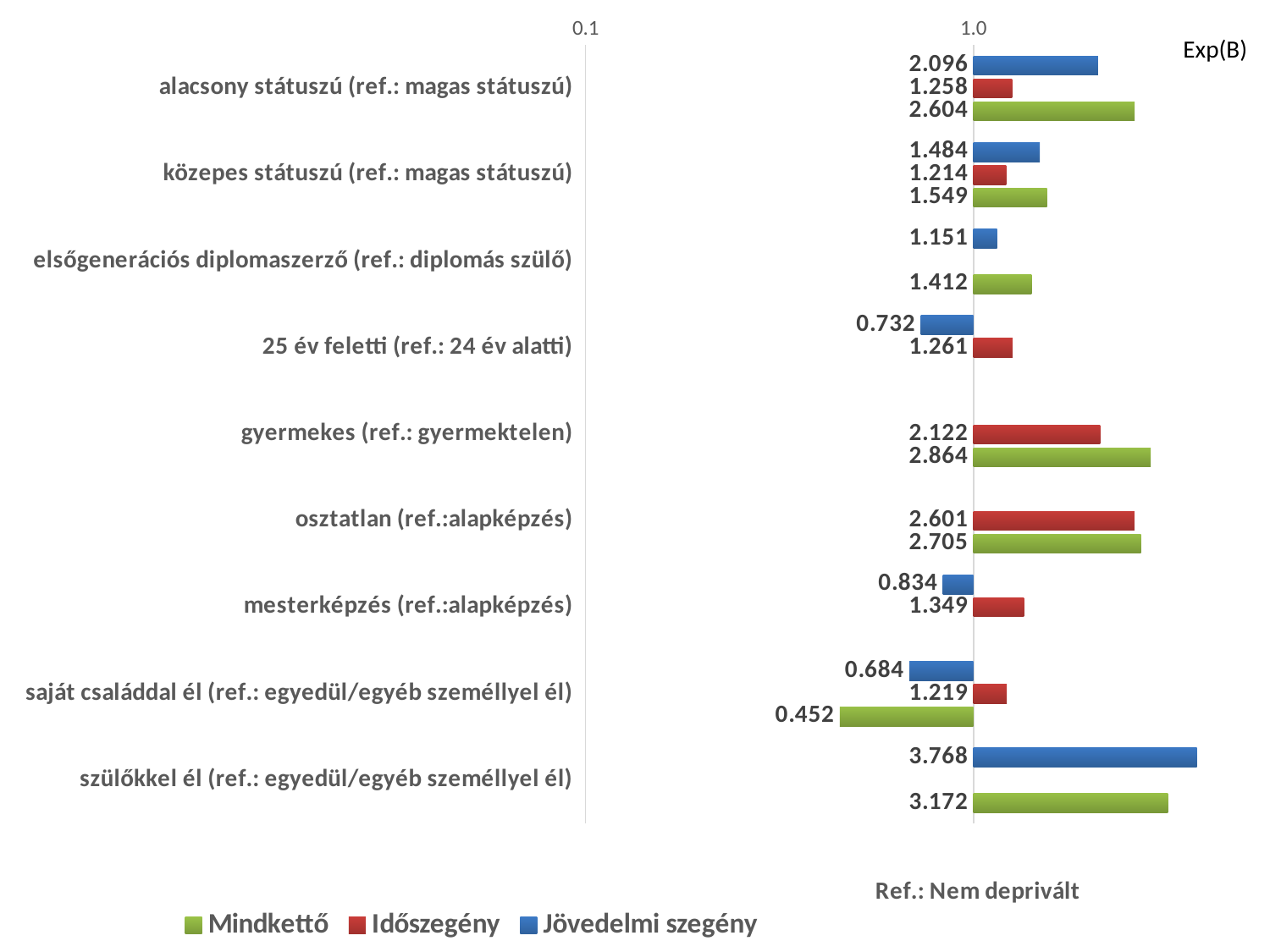
What is the Mindkettő value for 'saját családdal él (ref.: egyedül/egyéb személlyel él)'? 0.452 Which category has the lowest Mindkettő value? saját családdal él (ref.: egyedül/egyéb személlyel él) For 'szülőkkel él (ref.: egyedül/egyéb személlyel él)', which is larger: the Jövedelmi szegény value or the Mindkettő value? Jövedelmi szegény What kind of chart is shown on the slide? bar chart What is the Mindkettő value for 'gyermekes (ref.: gyermektelen)'? 2.864 What is the difference between the Mindkettő and Időszegény values for 'alacsony státuszú (ref.: magas státuszú)'? 1.346 How many categories are shown on the chart? 9 How many series does the legend list? 3 Which category has the highest Jövedelmi szegény value? szülőkkel él (ref.: egyedül/egyéb személlyel él) What is the Jövedelmi szegény value for 'alacsony státuszú (ref.: magas státuszú)'? 2.096 What is the Időszegény value for 'osztatlan (ref.:alapképzés)'? 2.601 Is the Jövedelmi szegény value for '25 év feletti (ref.: 24 év alatti)' greater or less than 1.0? less